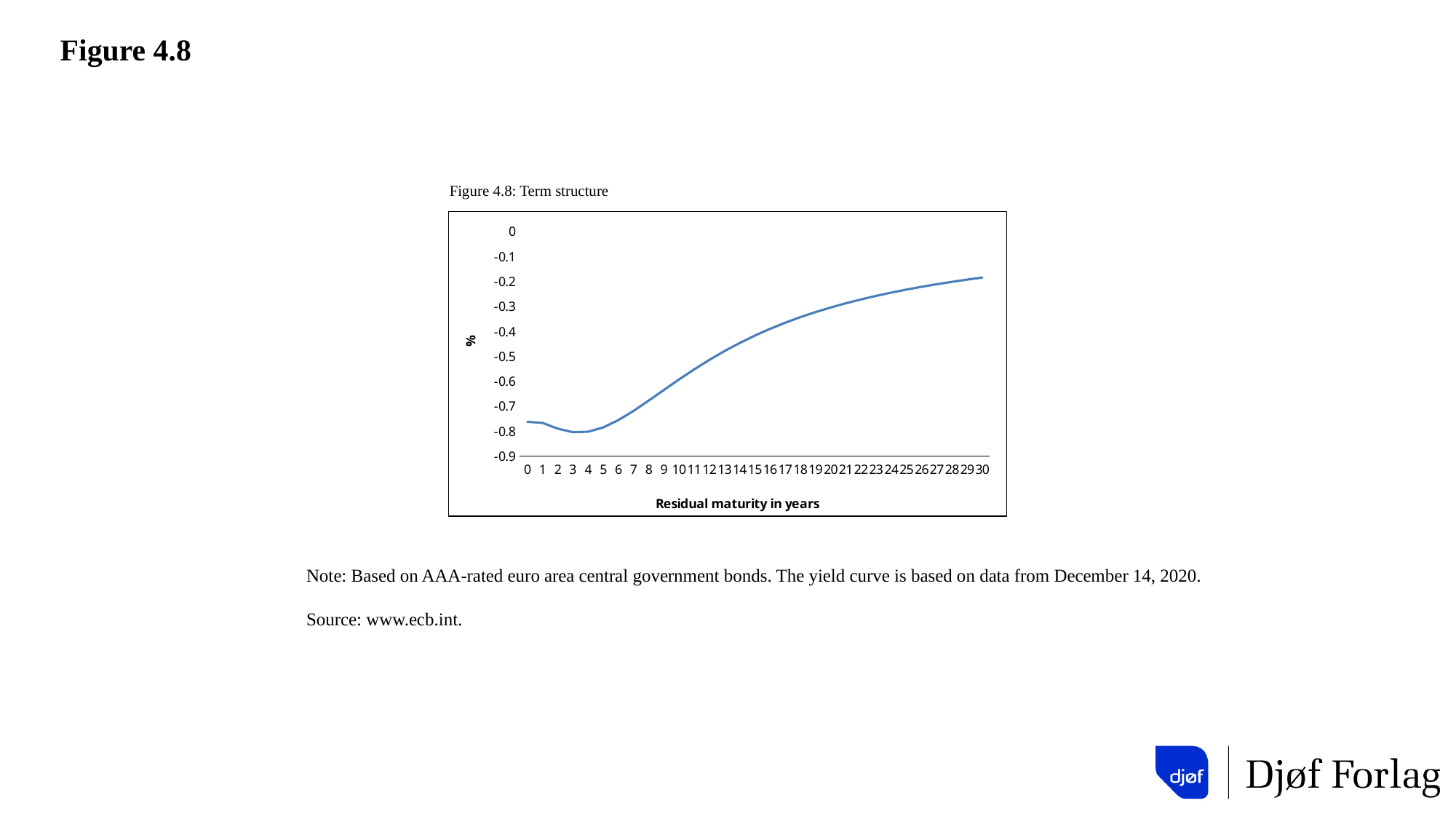
Is the value at a residual maturity of 0 years greater or less than -0.7? less Is the value at a residual maturity of 10 years greater or less than -0.7? greater Is the value at a residual maturity of 5 years greater or less than -0.7? less Which is larger, the value at a residual maturity of 25 years or at 5 years? 25 years What kind of chart is shown in Figure 4.8: Term structure? Line chart Overall, do the values rise or fall as residual maturity increases from 5 to 30 years? rise What is the label of the x axis? Residual maturity in years What is the title of the chart? Figure 4.8: Term structure How many residual maturity ticks are labelled on the x axis? 31 At which residual maturity is the yield highest? 30